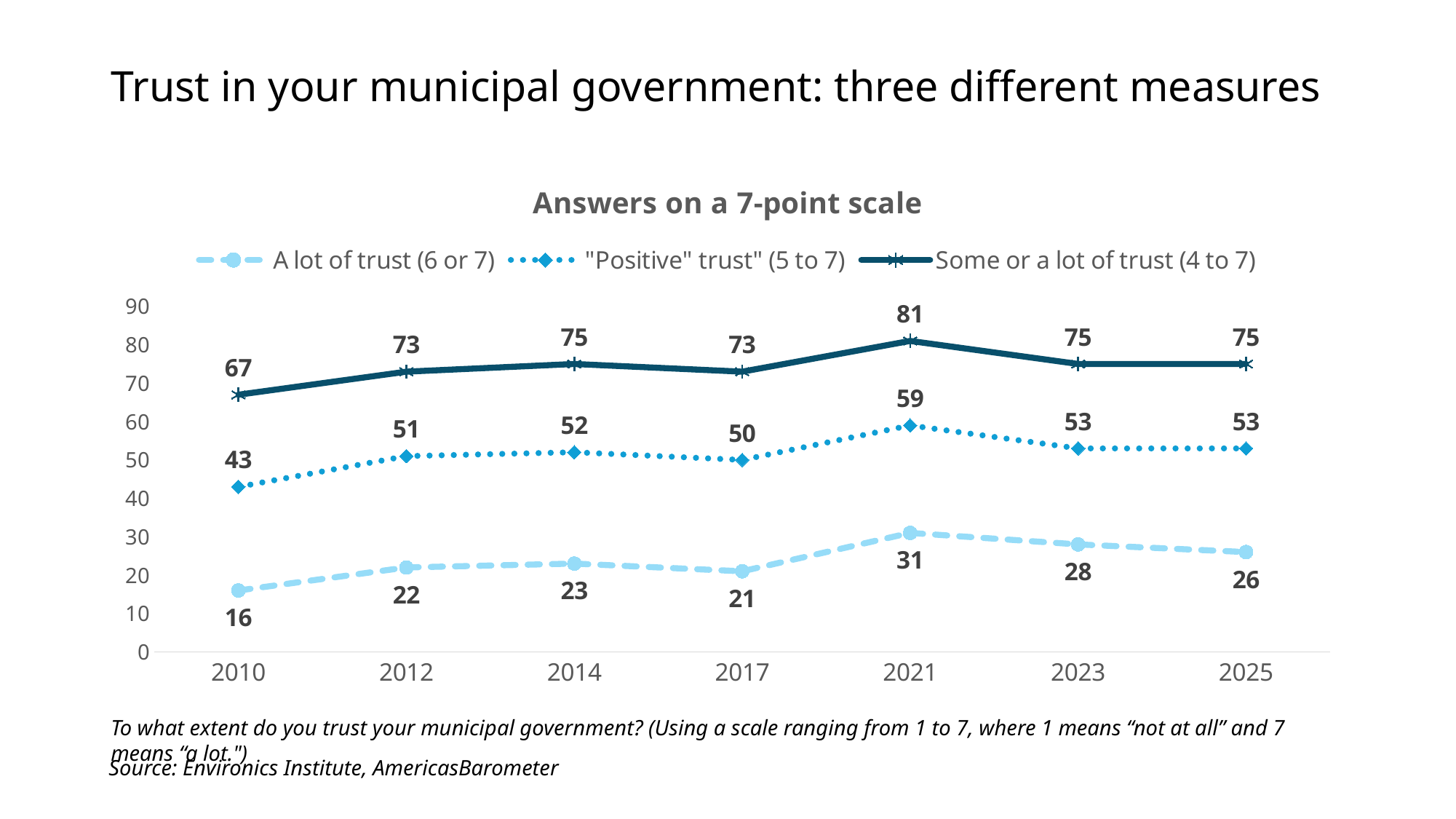
In which year is the "Some or a lot of trust (4 to 7)" series lowest? 2010 What is the value for "Positive" trust (5 to 7) in 2017? 50 In which year is the "A lot of trust (6 or 7)" series highest? 2021 What is the value for "Some or a lot of trust (4 to 7)" in 2021? 81 What is the value for "A lot of trust (6 or 7)" in 2010? 16 What is the difference between the "Some or a lot of trust (4 to 7)" value and the "A lot of trust (6 or 7)" value in 2025? 49 How many years are shown on the x axis? 7 Is the value for "A lot of trust (6 or 7)" in 2021 greater or less than 40? less Which is larger: the "Positive" trust (5 to 7) value in 2012 or in 2023? 2023 How many series does the legend list? 3 What kind of chart is shown on the slide? line chart Does the "Positive" trust (5 to 7) series rise or fall from 2021 to 2023? fall